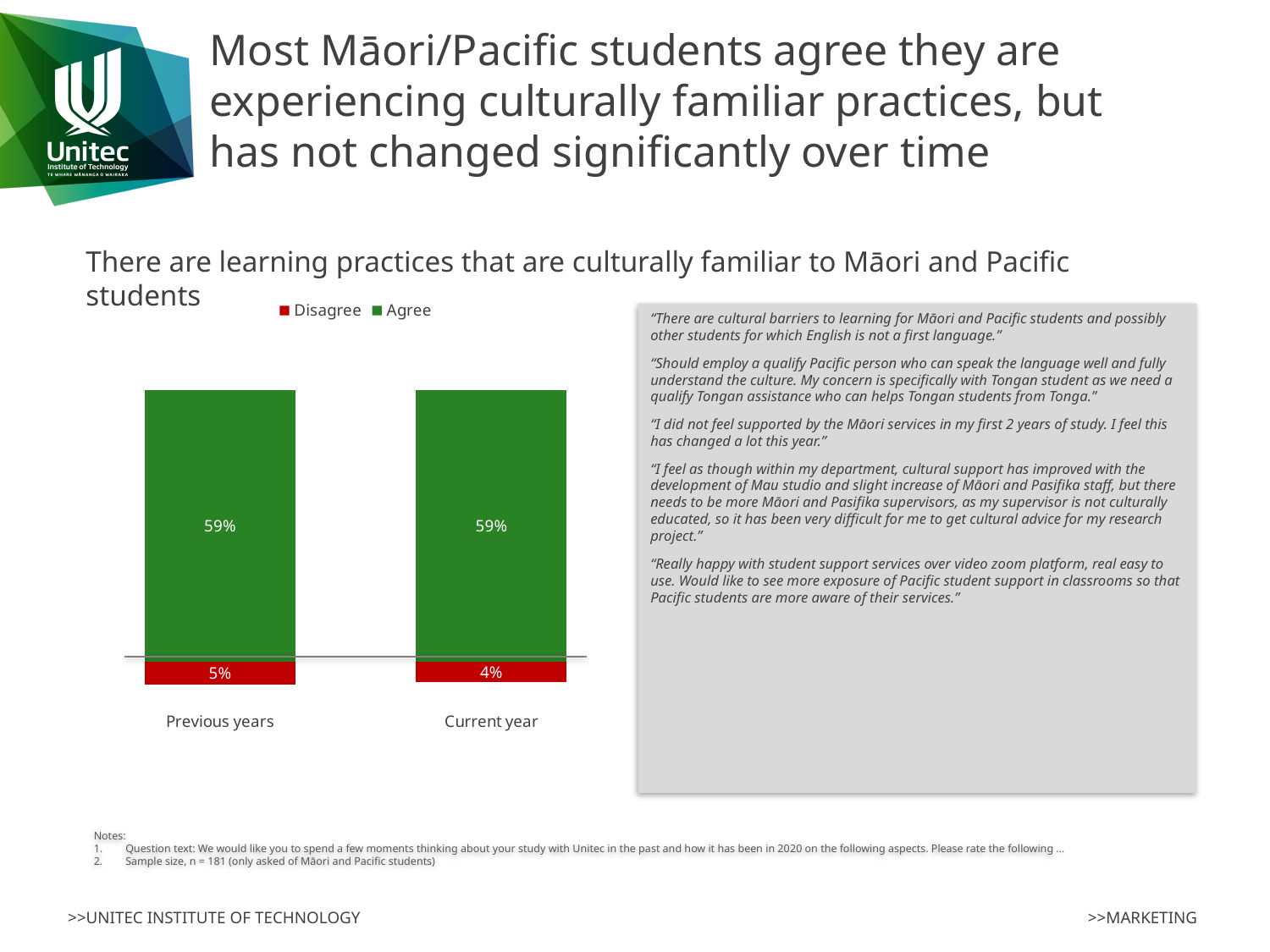
How many series does the legend list? 2 Which category has the higher Disagree value, Previous years or Current year? Previous years What is the Disagree value for Current year? 4% Which series is shown in green in the chart? Agree Does the Agree value rise, fall or stay the same from Previous years to Current year? Stays the same What kind of chart is shown on the slide? Bar chart What is the difference between the Disagree values for Previous years and Current year? 1% What is the Agree value for Current year? 59% How many categories are shown on the x axis? 2 What is the title of the chart? There are learning practices that are culturally familiar to Māori and Pacific students What is the Disagree value for Previous years? 5% What is the Agree value for Previous years? 59%